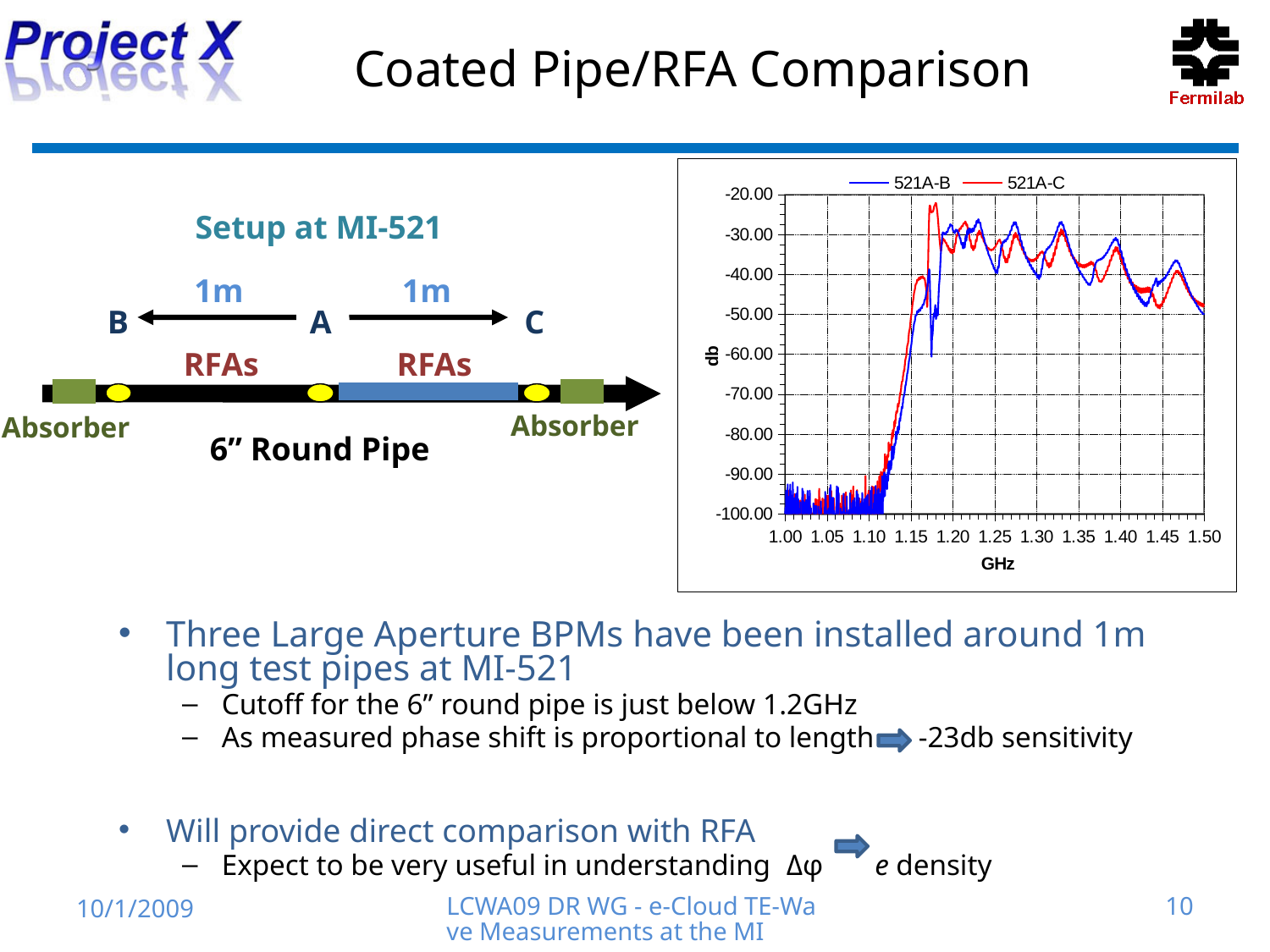
Is the value for 521A-B at 1.00 GHz greater or less than -80.00 db? less What are the names of the two series in the chart's legend? 521A-B and 521A-C Is the value for 521A-B at 1.30 GHz greater or less than -50.00 db? greater How many labelled tick marks are on the chart's GHz axis? 11 What is the label on the chart's vertical axis? db Is the value for 521A-C at 1.35 GHz greater or less than -50.00 db? greater How many series does the chart's legend list? 2 Between 1.10 GHz and 1.20 GHz, do the values of 521A-B rise or fall? rise What kind of chart is shown on the slide? line chart